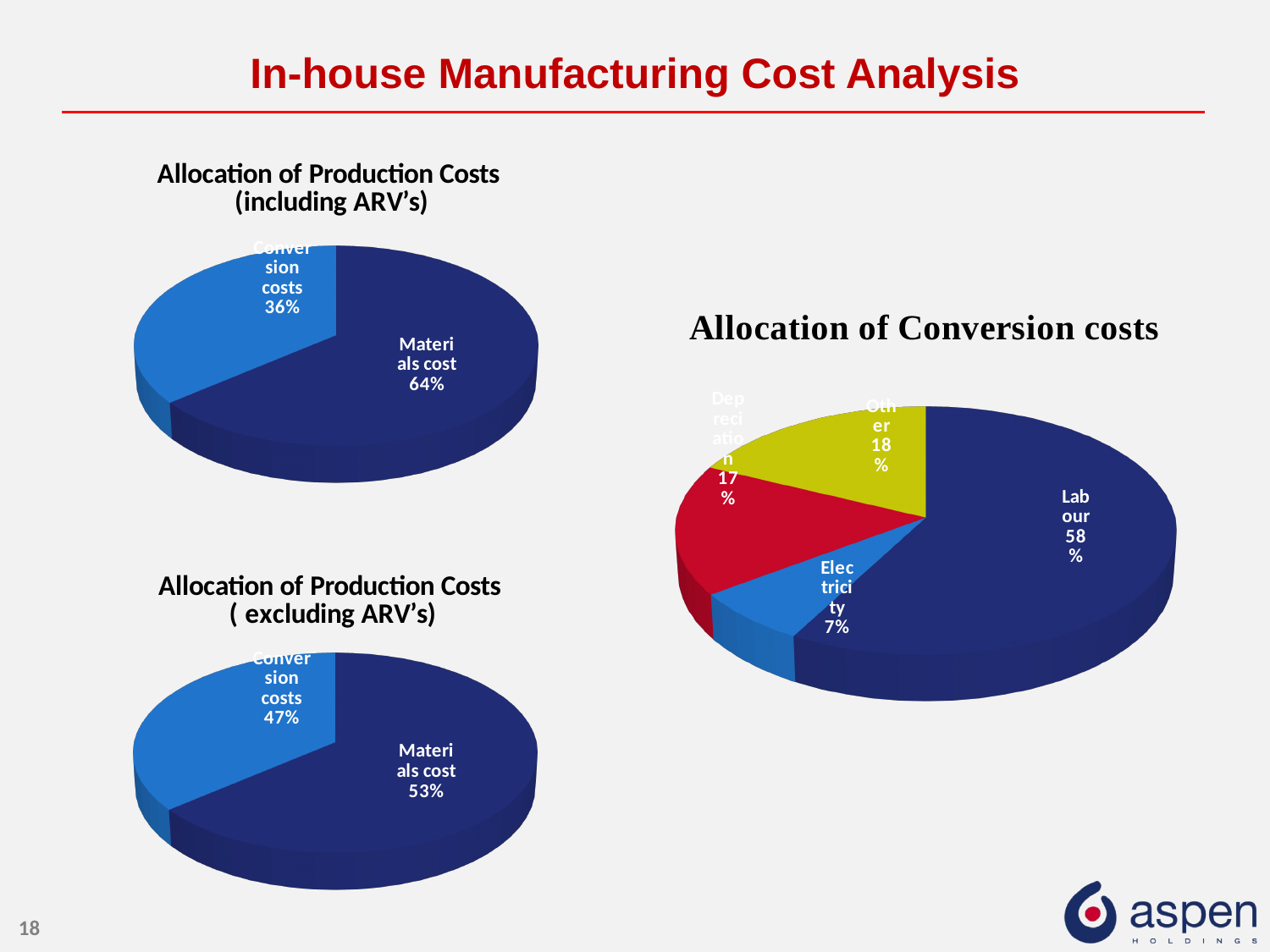
In the 'Allocation of Production Costs (including ARV's)' chart, what share is Conversion costs? 36% In the 'Allocation of Conversion costs' chart, which category has the largest share? Labour How many slices does the 'Allocation of Conversion costs' chart have? 4 In the 'Allocation of Production Costs ( excluding ARV's)' chart, what share is Conversion costs? 47% In the 'Allocation of Production Costs ( excluding ARV's)' chart, what share is Materials cost? 53% In the 'Allocation of Production Costs ( excluding ARV's)' chart, which is larger, Materials cost or Conversion costs? Materials cost In the 'Allocation of Conversion costs' chart, which category has the smallest share? Electricity In the 'Allocation of Conversion costs' chart, what share is Labour? 58% In the 'Allocation of Production Costs (including ARV's)' chart, what share is Materials cost? 64% What type of chart is the 'Allocation of Conversion costs' chart? Pie chart In the 'Allocation of Conversion costs' chart, what share is Electricity? 7% In the 'Allocation of Production Costs (including ARV's)' chart, what is the difference in percentage points between Materials cost and Conversion costs? 28